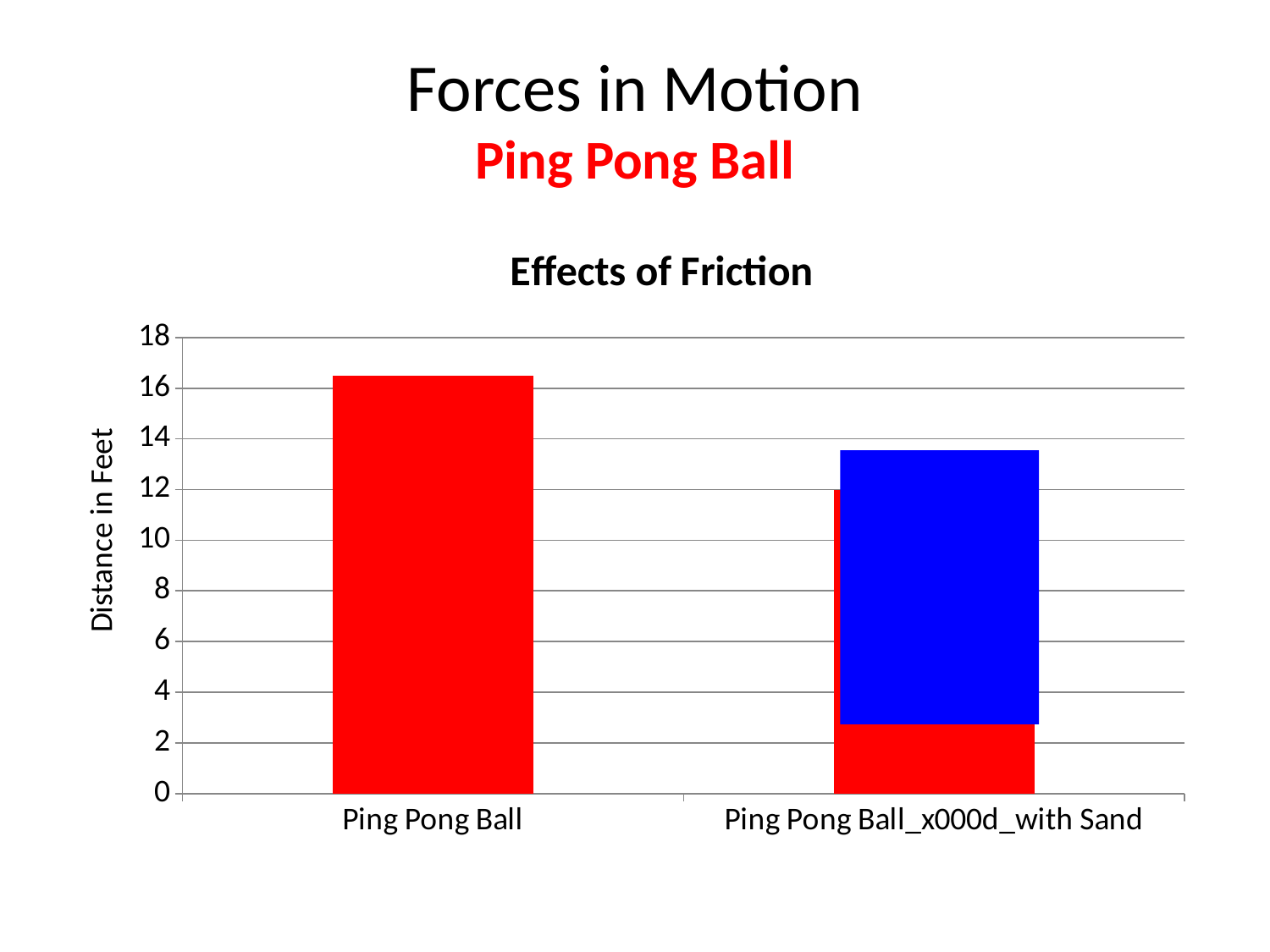
Is the value for Ping Pong Ball_x000d_with Sand greater or less than 10? greater How many categories are plotted on the x axis of the chart? 2 What is the title of the chart? Effects of Friction Is the value for Ping Pong Ball greater or less than 16? greater Is the value for Ping Pong Ball_x000d_with Sand greater or less than 14? less What kind of chart is shown on the slide? bar chart Which is larger, the value for Ping Pong Ball or the value for Ping Pong Ball_x000d_with Sand? Ping Pong Ball What is the label on the vertical axis of the chart? Distance in Feet Which category has the highest value in the chart? Ping Pong Ball Do the values rise or fall from left to right along the x axis? fall Which category has the lowest value in the chart? Ping Pong Ball_x000d_with Sand